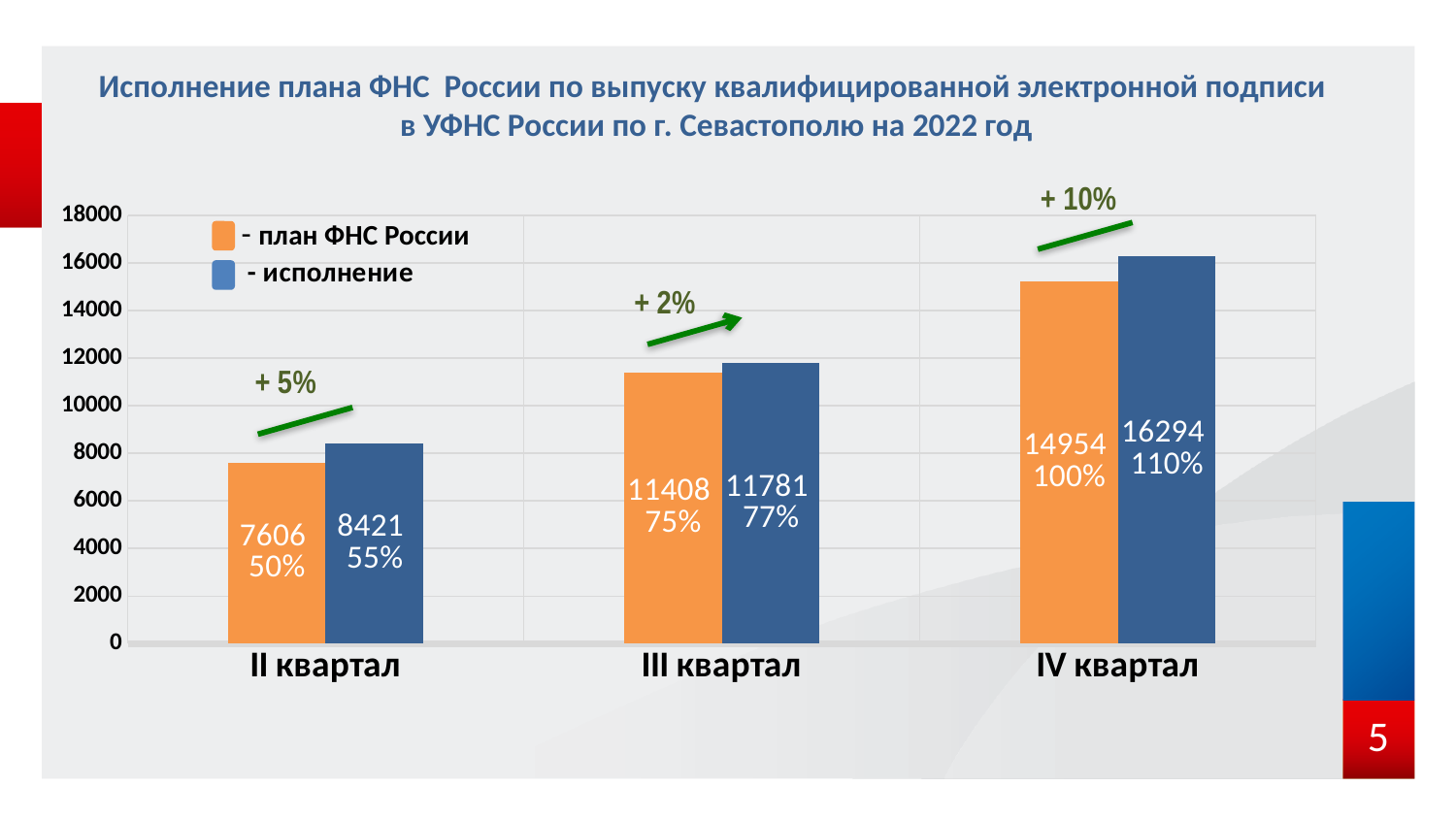
How many quarters are shown on the x axis? 3 What percentage is shown on the 'план ФНС России' bar for III квартал? 75% What is the value of 'исполнение' for IV квартал? 16294 What is the value of 'план ФНС России' for II квартал? 7606 Which is larger for III квартал: 'план ФНС России' or 'исполнение'? исполнение What kind of chart is shown on the slide? bar chart Which quarter has the highest 'исполнение' value? IV квартал Which quarter has the lowest 'план ФНС России' value? II квартал What is the difference between 'исполнение' and 'план ФНС России' for II квартал? 815 What is the difference between 'исполнение' and 'план ФНС России' for IV квартал? 1340 How many series does the legend list? 2 What is the value of 'исполнение' for III квартал? 11781